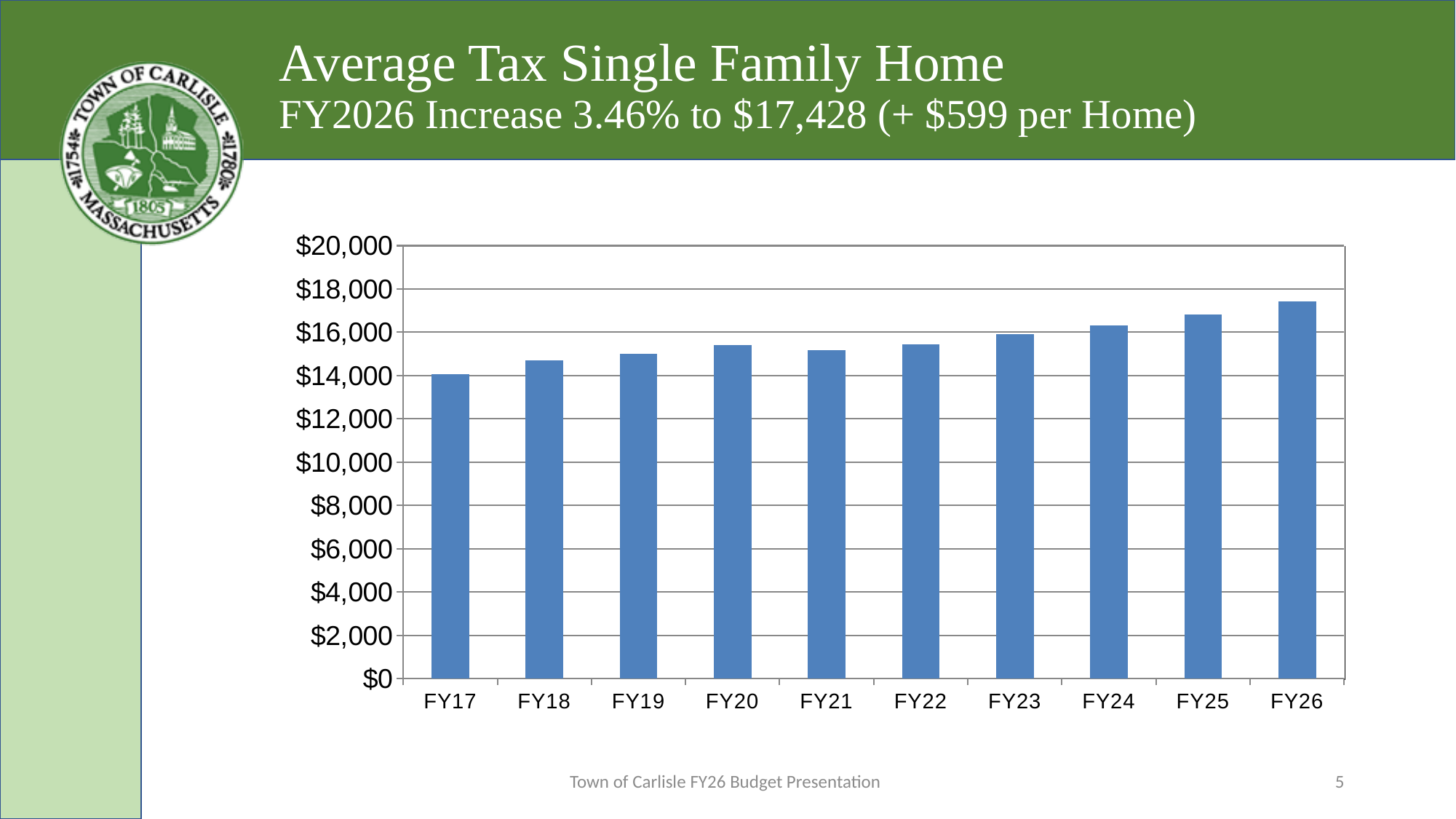
Is the value for FY26 greater or less than $18,000? less According to the slide, what is the average tax for a single family home in FY2026? $17,428 Is the value for FY21 greater or less than $16,000? less Which is larger, the value for FY25 or the value for FY22? FY25 Which fiscal year has the lowest average tax bar? FY17 Do the values generally rise or fall from FY17 to FY26? rise Is the value for FY17 greater or less than $16,000? less How many fiscal years are plotted on the chart? 10 Which fiscal year has the highest average tax bar? FY26 What kind of chart is shown on the slide? bar chart What is the highest value shown on the vertical axis? $20,000